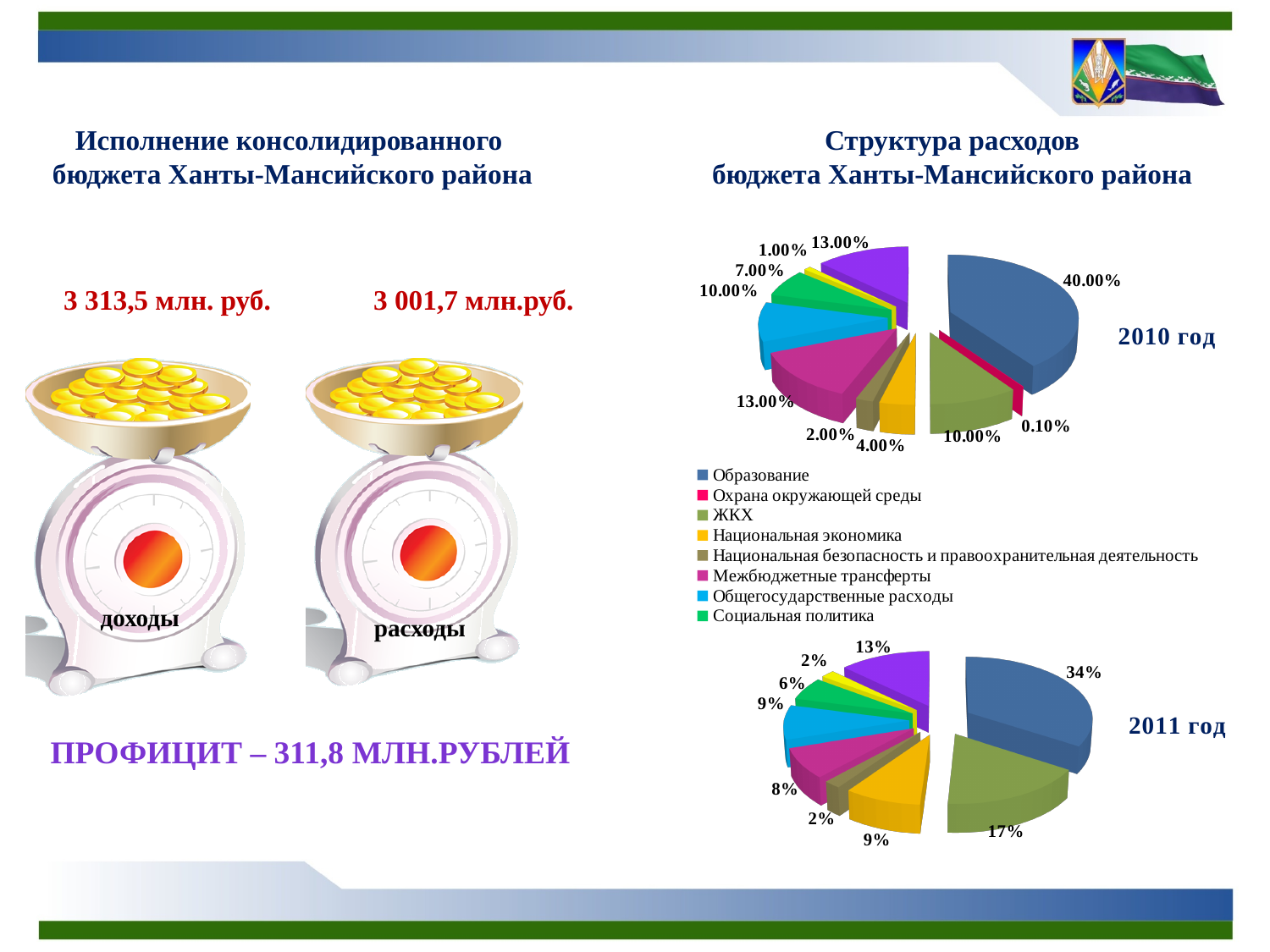
In the 2010 pie chart, what share is shown for Образование? 40.00% In the 2011 pie chart, what share is shown for Национальная экономика? 9% In the 2010 pie chart, which category has the largest share? Образование In the 2010 pie chart, what share is shown for Межбюджетные трансферты? 13.00% In the 2011 pie chart, what share is shown for ЖКХ? 17% In the 2011 pie chart, what share is shown for Образование? 34% Is the share of Образование larger in the 2010 pie chart or the 2011 pie chart? 2010 What type of chart is used to show the structure of expenditures for 2010 and 2011? Pie chart By how many percentage points does the share of Образование in the 2010 pie chart exceed its share in the 2011 pie chart? 6 In the 2010 pie chart, which legend category has the smallest share? Охрана окружающей среды In the 2011 pie chart, what share is shown for Социальная политика? 6% How many categories does the legend between the two pie charts list? 8